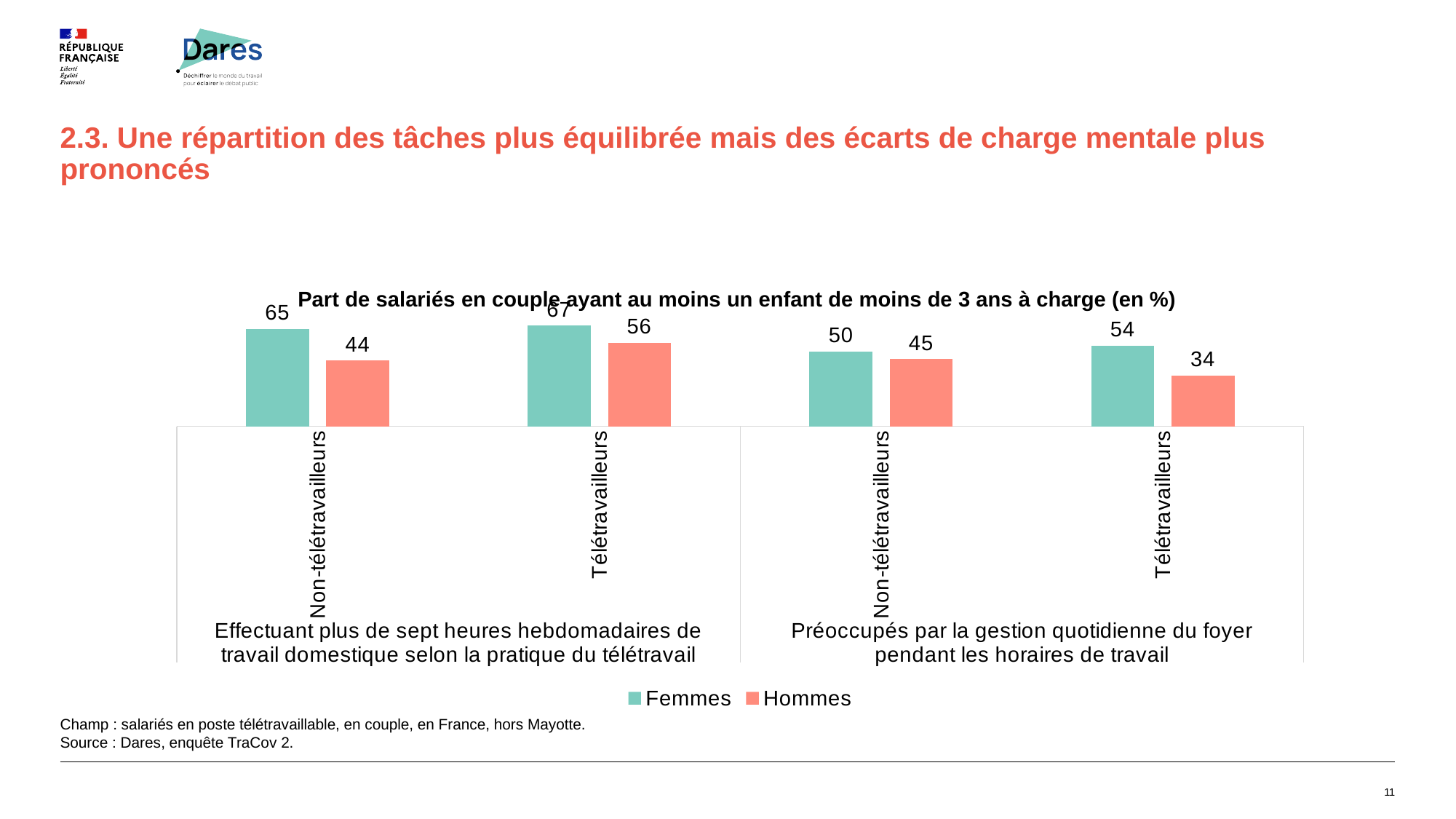
Among Non-télétravailleurs in the group 'Préoccupés par la gestion quotidienne du foyer', which is larger, Femmes or Hommes? Femmes What kind of chart is shown on the slide? Bar chart Which bar has the lowest value on the chart? Hommes, Télétravailleurs (gestion quotidienne du foyer), 34 What is the value for Femmes among Non-télétravailleurs in the group 'Effectuant plus de sept heures hebdomadaires de travail domestique selon la pratique du télétravail'? 65 What is the value for Hommes among Télétravailleurs in the group 'Effectuant plus de sept heures hebdomadaires de travail domestique selon la pratique du télétravail'? 56 What is the difference between Femmes and Hommes among Non-télétravailleurs in the group 'Effectuant plus de sept heures hebdomadaires de travail domestique'? 21 What is the difference between Femmes and Hommes among Télétravailleurs in the group 'Préoccupés par la gestion quotidienne du foyer pendant les horaires de travail'? 20 What is the value for Hommes among Télétravailleurs in the group 'Préoccupés par la gestion quotidienne du foyer pendant les horaires de travail'? 34 Which bar has the highest value on the chart? Femmes, Télétravailleurs (travail domestique), 67 What is the title of the chart? Part de salariés en couple ayant au moins un enfant de moins de 3 ans à charge (en %) What is the value for Femmes among Non-télétravailleurs in the group 'Préoccupés par la gestion quotidienne du foyer pendant les horaires de travail'? 50 How many series does the legend list? 2